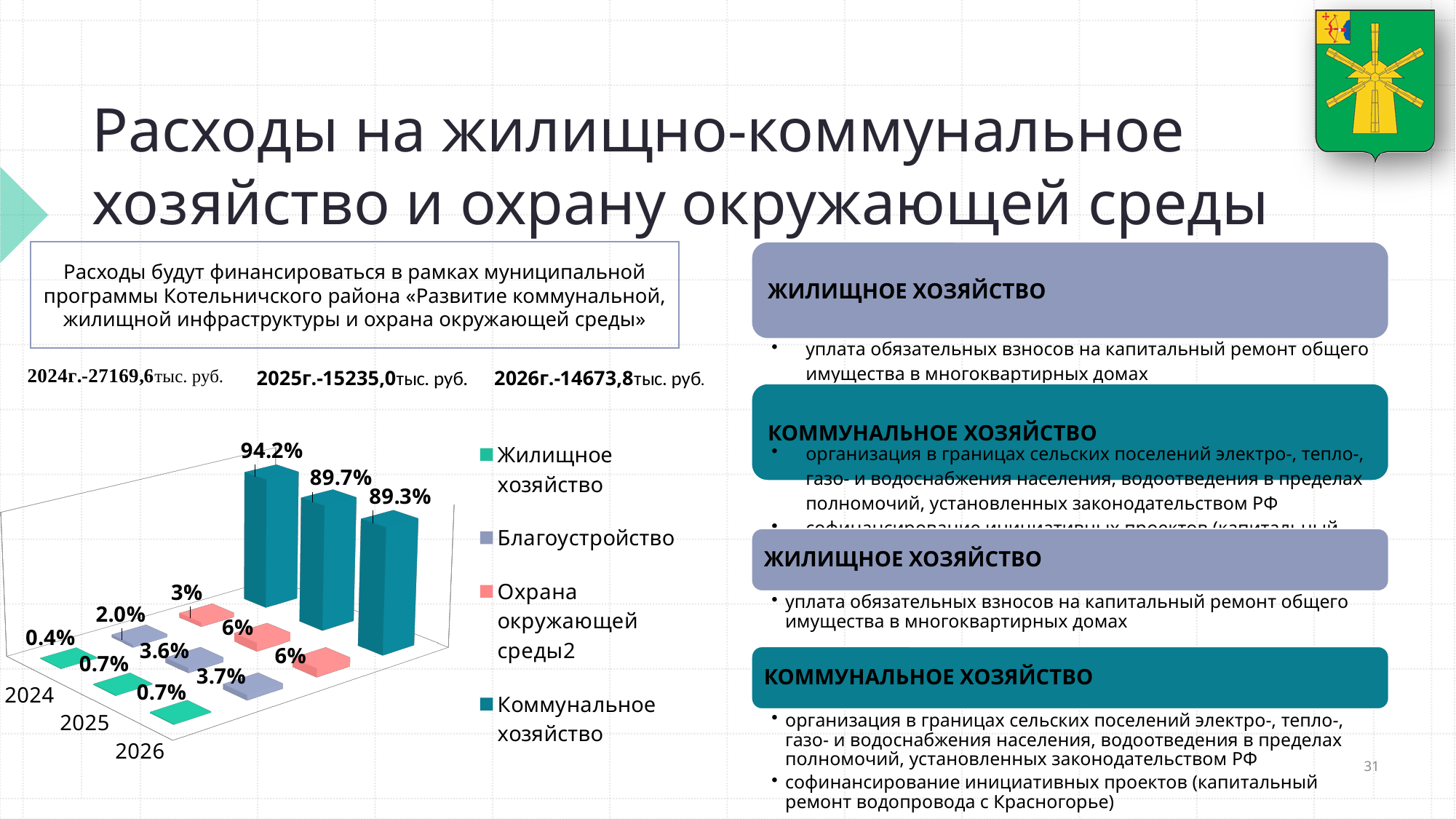
What is the value for Жилищное хозяйство in 2024? 0.4% Which series has the highest value in 2025? Коммунальное хозяйство What is the value for Охрана окружающей среды2 in 2026? 6% What kind of chart is shown on the slide? bar chart What is the value for Коммунальное хозяйство in 2024? 94.2% Which series has the lowest value in 2026? Жилищное хозяйство What is the difference between the Коммунальное хозяйство values for 2024 and 2025? 4.5% How many years are shown on the chart's axis? 3 Does the value for Коммунальное хозяйство rise or fall from 2024 to 2026? fall What is the value for Коммунальное хозяйство in 2026? 89.3% What is the value for Благоустройство in 2025? 3.6% How many series does the chart legend list? 4